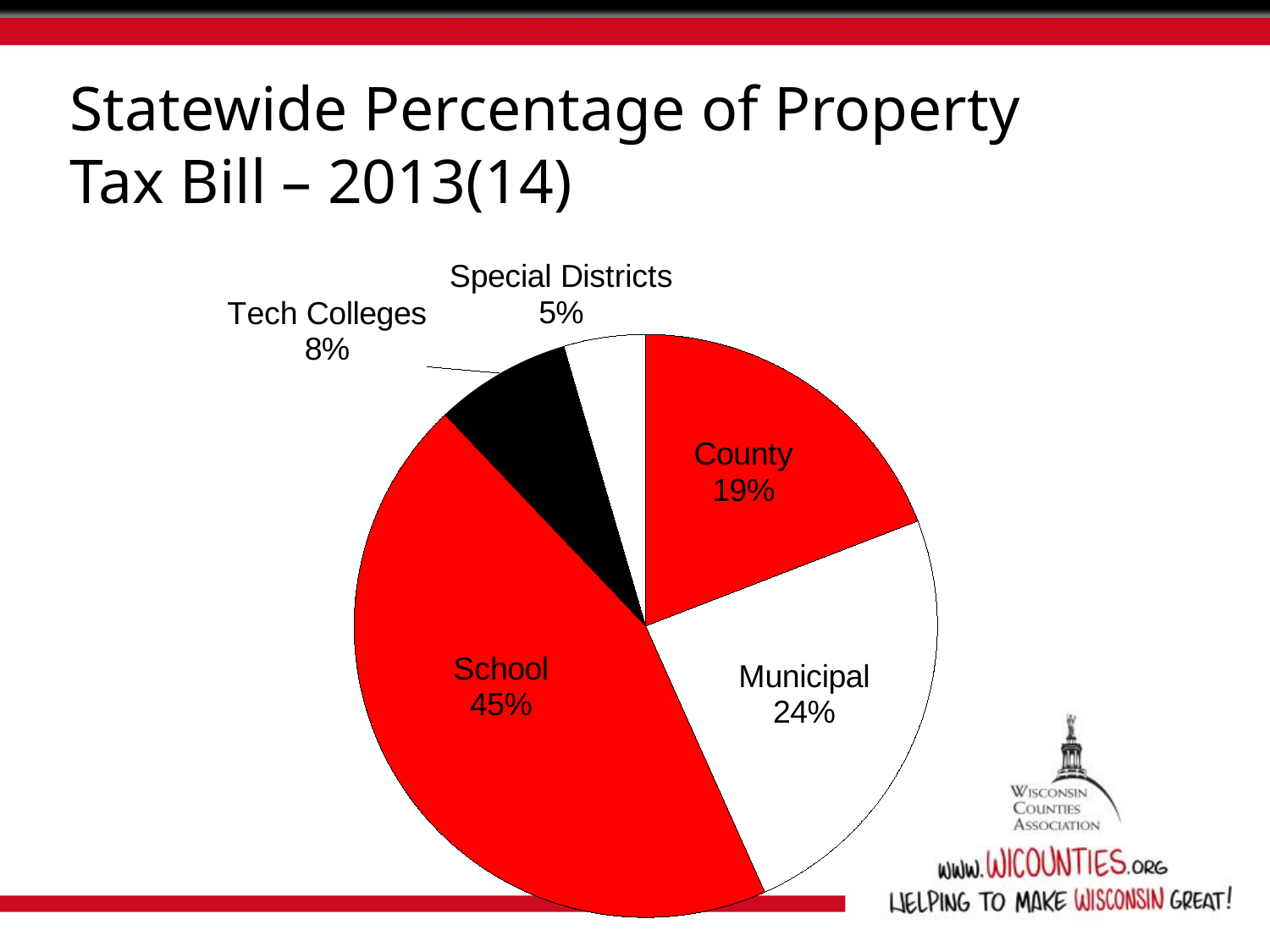
Which is larger, the County share or the Municipal share? Municipal What type of chart is shown on the slide? pie chart Which category has the smallest share of the property tax bill? Special Districts What percentage of the property tax bill goes to Special Districts? 5% How many categories are shown in the pie chart? 5 What percentage of the property tax bill goes to Tech Colleges? 8% What is the difference in percentage points between the Municipal and County shares? 5 What percentage of the property tax bill goes to Municipal? 24% What is the title of the slide containing the chart? Statewide Percentage of Property Tax Bill – 2013(14) What percentage of the property tax bill goes to County? 19% Which category has the largest share of the property tax bill? School What percentage of the property tax bill goes to School? 45%